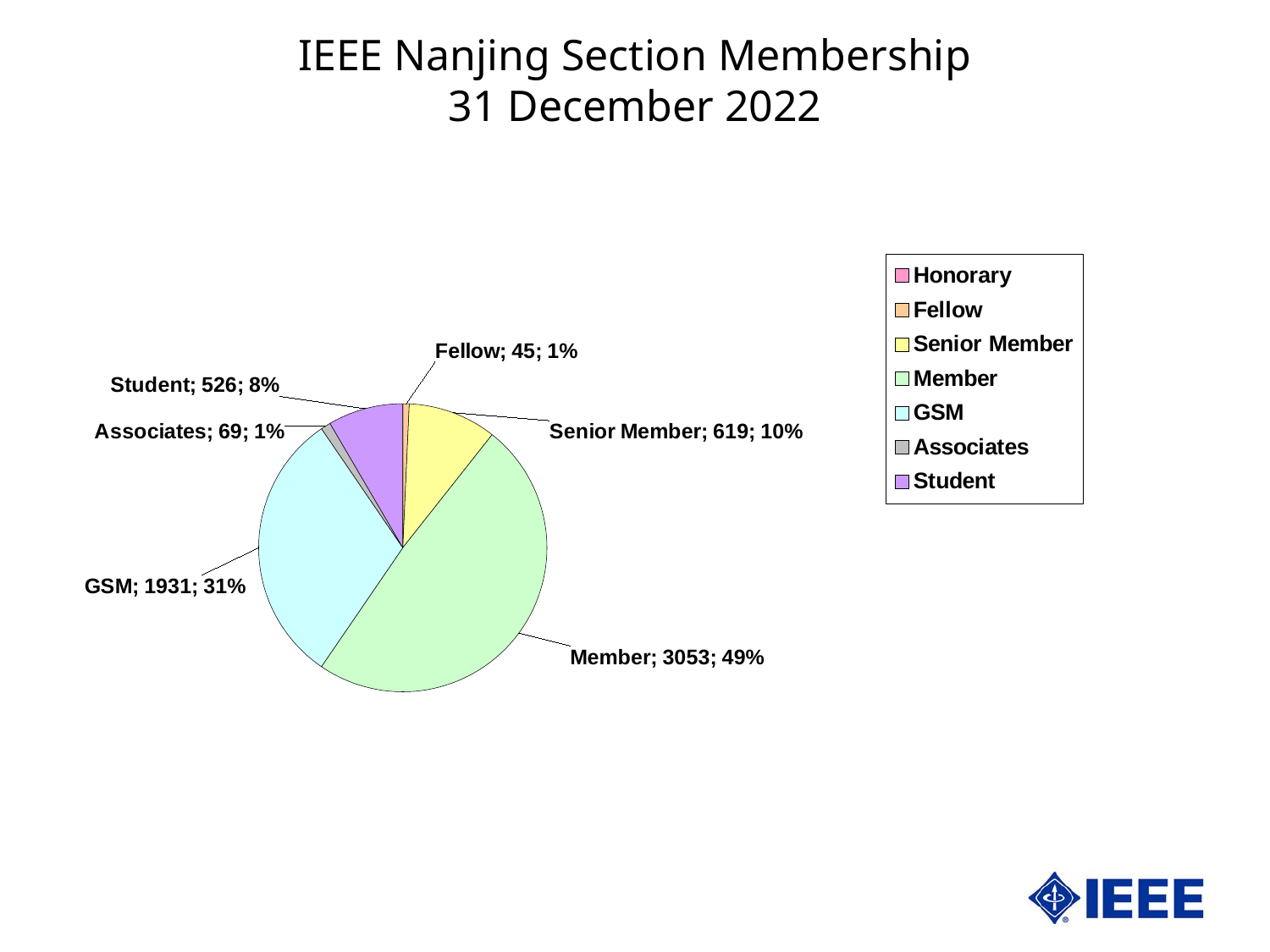
Which category has the largest slice of the pie? Member How many members are in the Member category? 3053 What is the title of the chart? IEEE Nanjing Section Membership 31 December 2022 Which is larger, the Fellow count or the Associates count? Associates What kind of chart is shown on the slide? pie chart How many entries does the legend list? 7 What is the value for Student? 526 How many Senior Members are shown? 619 What percentage of the pie does Member account for? 49% What is the difference between the Senior Member count and the Student count? 93 What share of the pie does GSM represent? 31% What is the difference between the Member count and the GSM count? 1122